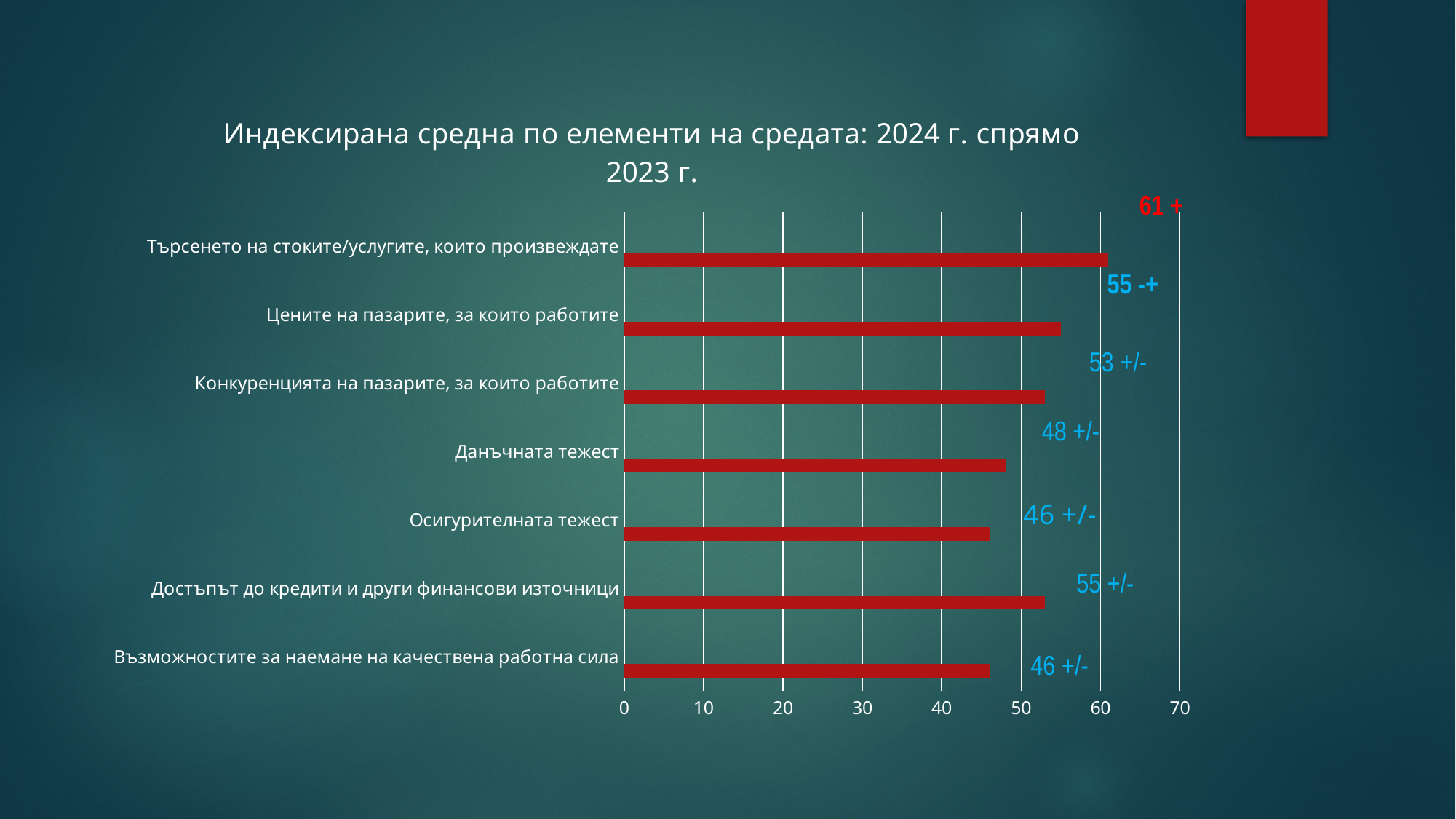
Which is larger: the value for "Цените на пазарите, за които работите" or for "Данъчната тежест"? Цените на пазарите, за които работите What is the value for "Данъчната тежест"? 48 What is the difference between the value for "Търсенето на стоките/услугите, които произвеждате" and the value for "Данъчната тежест"? 13 What is the value for "Търсенето на стоките/услугите, които произвеждате"? 61 What is the value for "Цените на пазарите, за които работите"? 55 What kind of chart is shown on the slide? bar chart Which category has the highest value in the chart? Търсенето на стоките/услугите, които произвеждате Is the value for "Търсенето на стоките/услугите, които произвеждате" greater or less than 60? greater Is the value for "Осигурителната тежест" greater or less than 50? less How many categories are plotted in the chart? 7 What is the title of the chart? Индексирана средна по елементи на средата: 2024 г. спрямо 2023 г. Is the value for "Достъпът до кредити и други финансови източници" greater or less than 50? greater